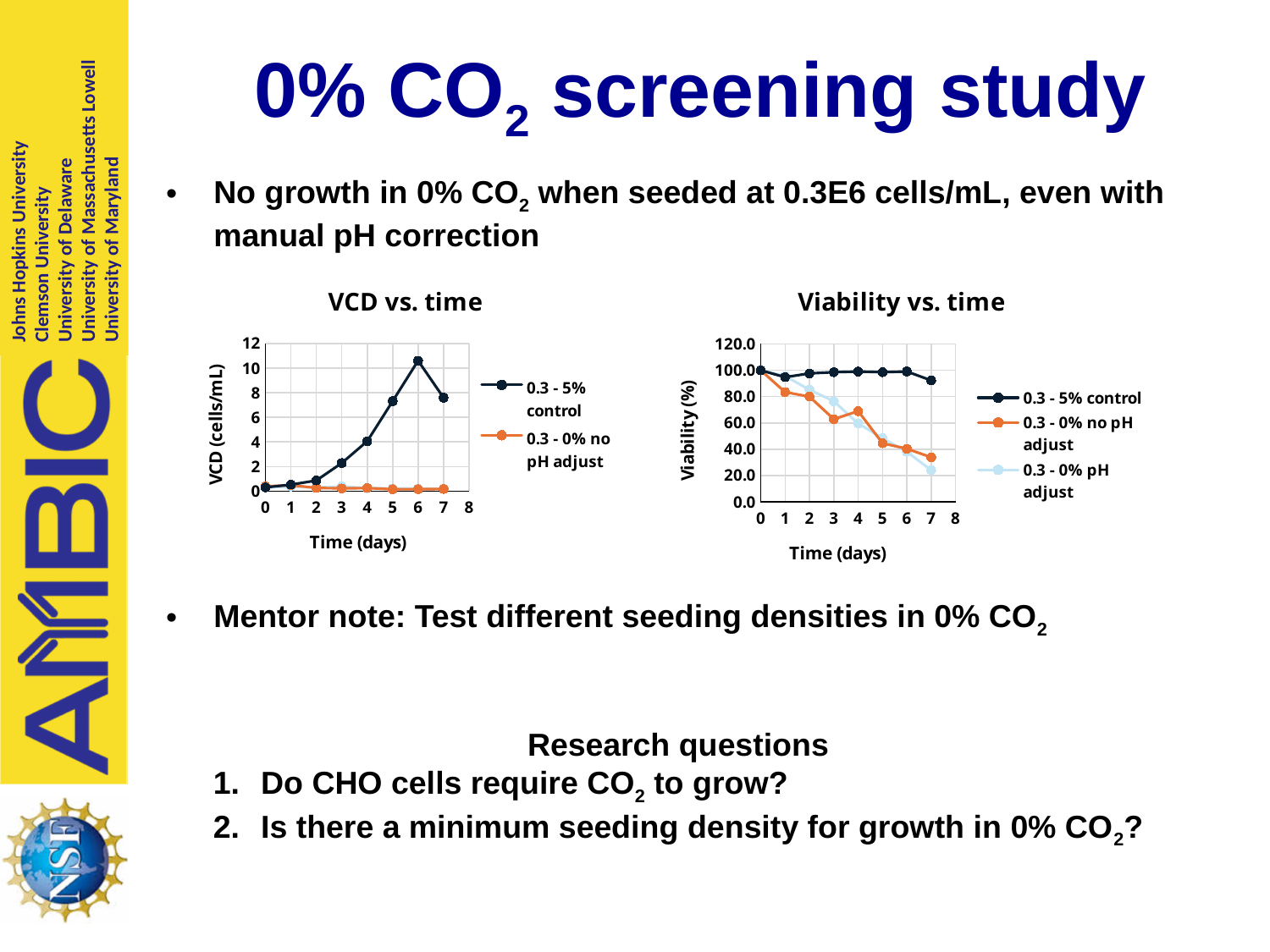
In the 'VCD vs. time' chart, on which day does the '0.3 - 5% control' series reach its highest value? 6 In the 'VCD vs. time' chart, does the '0.3 - 5% control' series rise or fall between day 6 and day 7? fall In the 'VCD vs. time' chart, how many data points are plotted for the '0.3 - 5% control' series? 8 What kind of chart is the 'VCD vs. time' chart? line chart In the 'Viability vs. time' chart, does the '0.3 - 0% pH adjust' series rise or fall over time? fall In the 'Viability vs. time' chart, is the value of the '0.3 - 0% no pH adjust' series at day 7 greater or less than 40? less In the 'VCD vs. time' chart, is the value of the '0.3 - 5% control' series at day 6 greater or less than 8? greater How many series does the legend of the 'Viability vs. time' chart list? 3 In the 'Viability vs. time' chart, is the value of the '0.3 - 5% control' series at day 7 greater or less than 80? greater How many series does the legend of the 'VCD vs. time' chart list? 2 In the 'Viability vs. time' chart, at day 7, which series has the higher value: '0.3 - 0% no pH adjust' or '0.3 - 0% pH adjust'? 0.3 - 0% no pH adjust What is the y-axis label of the 'Viability vs. time' chart? Viability (%)